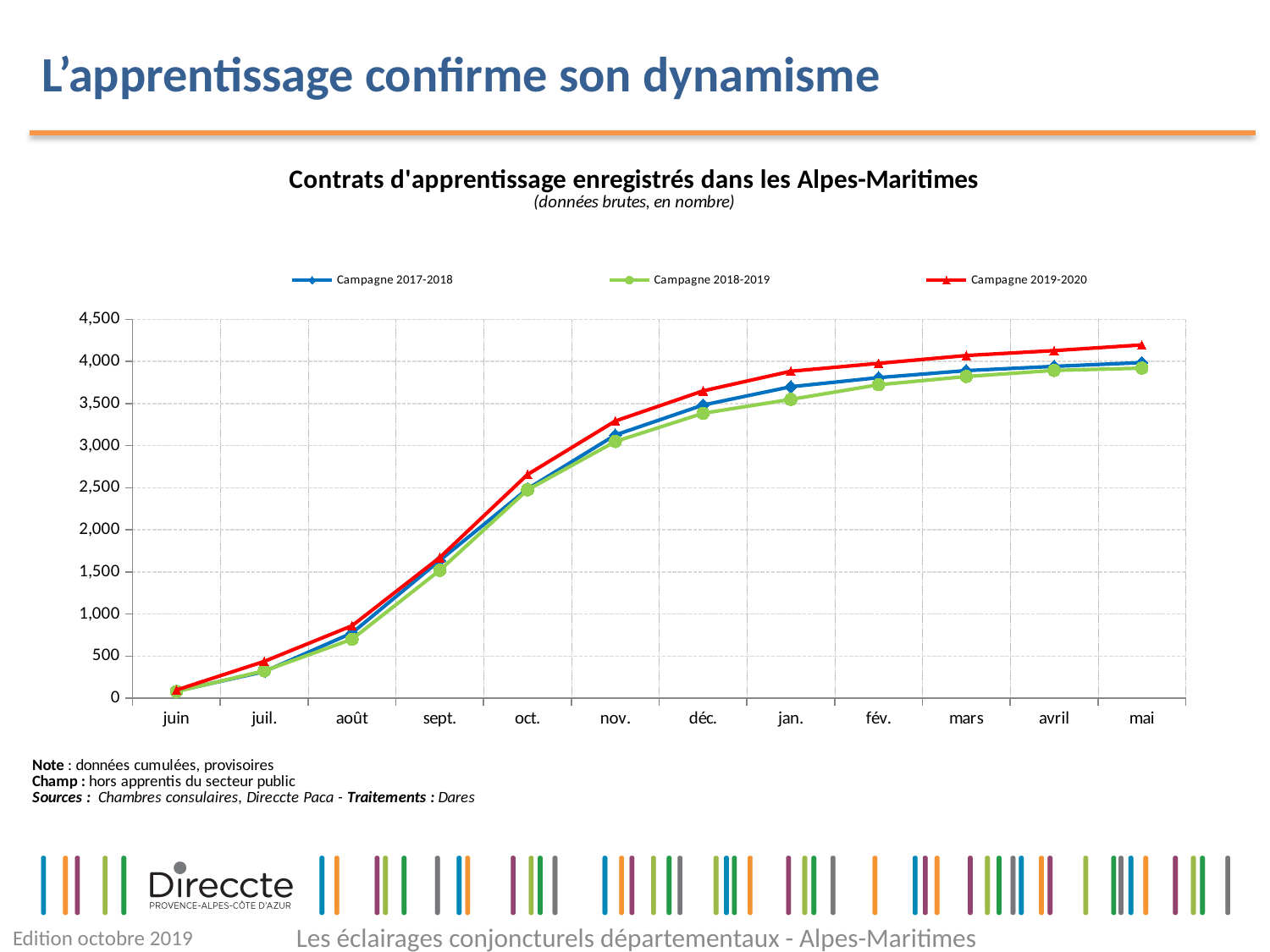
What kind of chart is shown on the slide? line chart In déc., which is larger: the value for Campagne 2017-2018 or for Campagne 2018-2019? Campagne 2017-2018 Is the value for Campagne 2018-2019 in août greater or less than 1,000? less Is the value for Campagne 2019-2020 in mai greater or less than 4,000? greater Is the value for Campagne 2018-2019 in mai greater or less than 4,000? less What is the title of the chart? Contrats d'apprentissage enregistrés dans les Alpes-Maritimes How many series does the legend list? 3 Which campaign has the lowest value in mai? Campagne 2018-2019 In which month is the value for Campagne 2019-2020 lowest? juin How many months are shown along the x axis? 12 Do the values for Campagne 2019-2020 rise or fall from juin to mai? rise Which campaign has the highest value in mai? Campagne 2019-2020